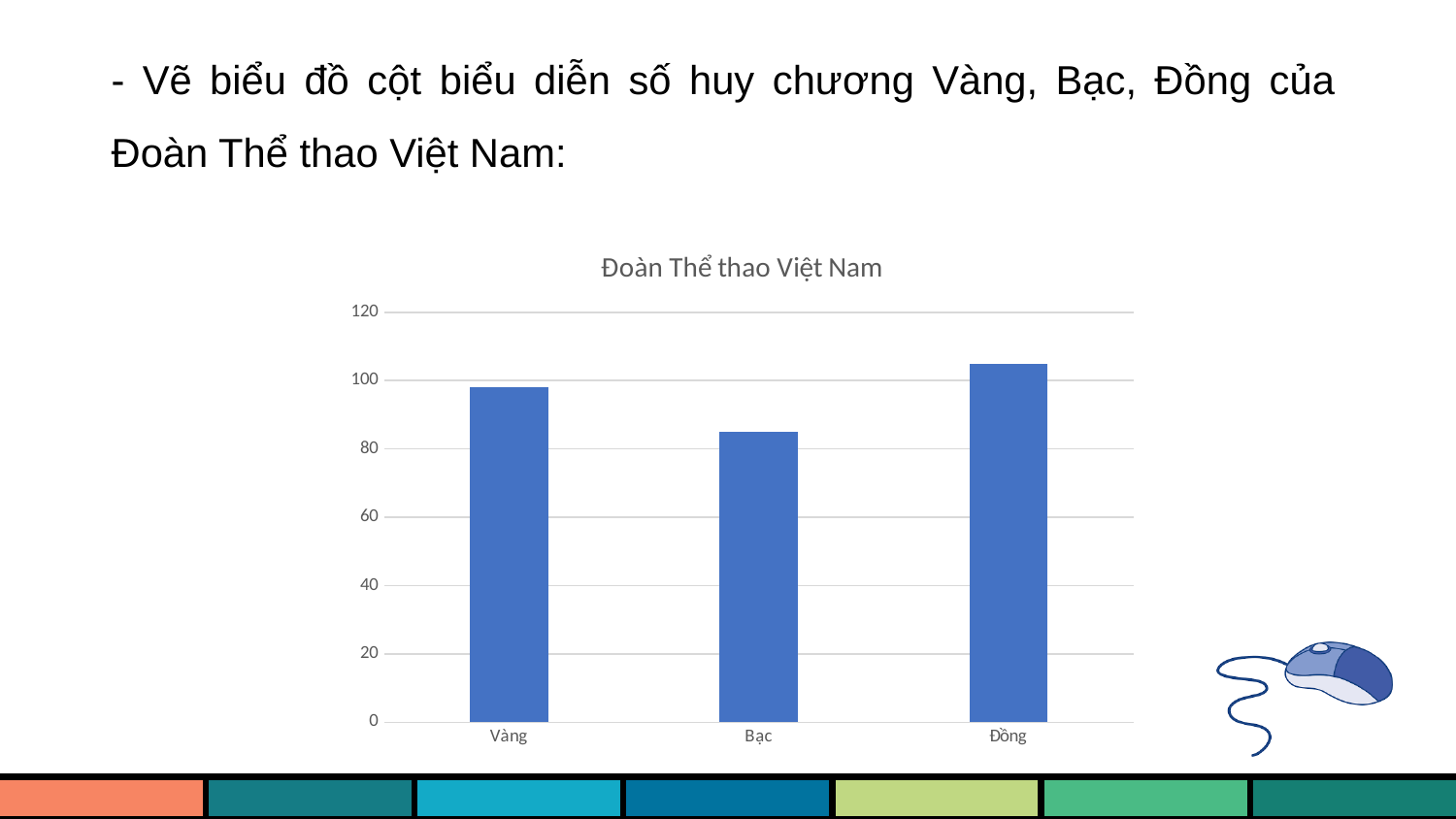
What kind of chart is shown on the slide? bar chart Is the value for Đồng greater or less than 100? greater Is the value for Vàng greater or less than 80? greater Which is larger, the value for Đồng or the value for Bạc? Đồng What is the title of the chart? Đoàn Thể thao Việt Nam Which category has the lowest bar in the chart? Bạc Is the value for Bạc greater or less than 60? greater How many categories are shown on the x axis of the chart? 3 What is the highest value shown on the vertical axis of the chart? 120 Which is larger, the value for Vàng or the value for Bạc? Vàng Which category has the highest bar in the chart? Đồng